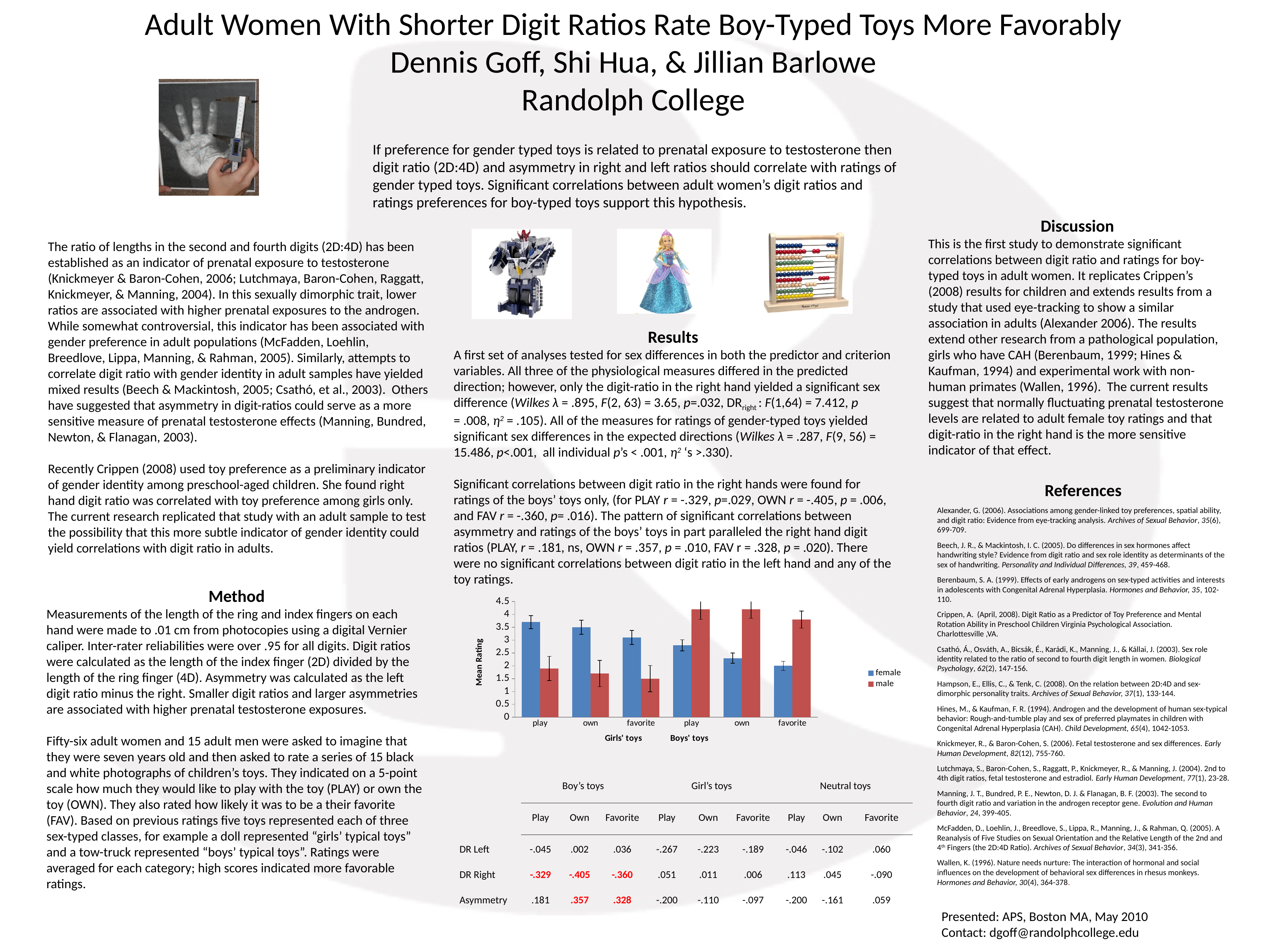
Is the female mean rating for 'play' under Girls' toys greater or less than 3? greater How many category groups of bars are plotted along the x axis of the chart? 6 Do the female mean ratings rise or fall from 'play' to 'own' to 'favorite' under Girls' toys? fall For 'favorite' under Boys' toys, which series has the higher mean rating, female or male? male How many series does the chart legend list? 2 Which colour represents the male series in the chart? red Is the male mean rating for 'own' under Boys' toys greater or less than 3.5? greater Is the male mean rating for 'play' under Girls' toys greater or less than 2.5? less What kind of chart is shown on the slide? bar chart For 'own' under Girls' toys, which series has the higher mean rating, female or male? female What is the label of the y axis of the chart? Mean Rating